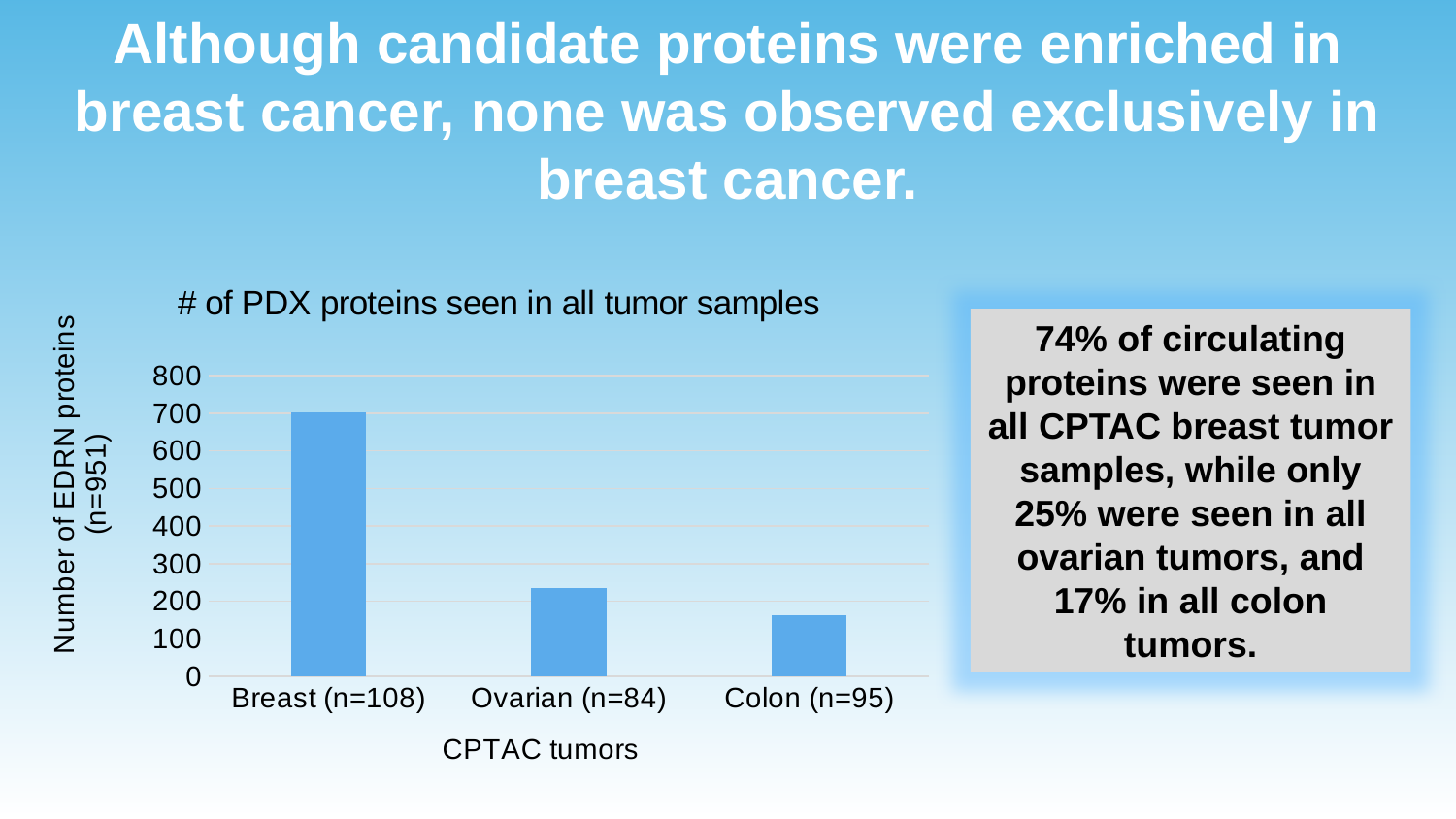
Which tumor category has the lowest number of EDRN proteins? Colon (n=95) Is the value for Colon (n=95) greater or less than 200? less Do the values rise or fall moving from left to right across the categories? Fall Which tumor category has the highest number of EDRN proteins? Breast (n=108) What kind of chart is shown on the slide? Bar chart Which has a larger value, Ovarian (n=84) or Colon (n=95)? Ovarian (n=84) Is the value for Breast (n=108) greater or less than 600? greater How many tumor categories are plotted on the chart? 3 Is the value for Colon (n=95) greater or less than 100? greater What is the title of the chart? # of PDX proteins seen in all tumor samples What is the label of the x axis? CPTAC tumors